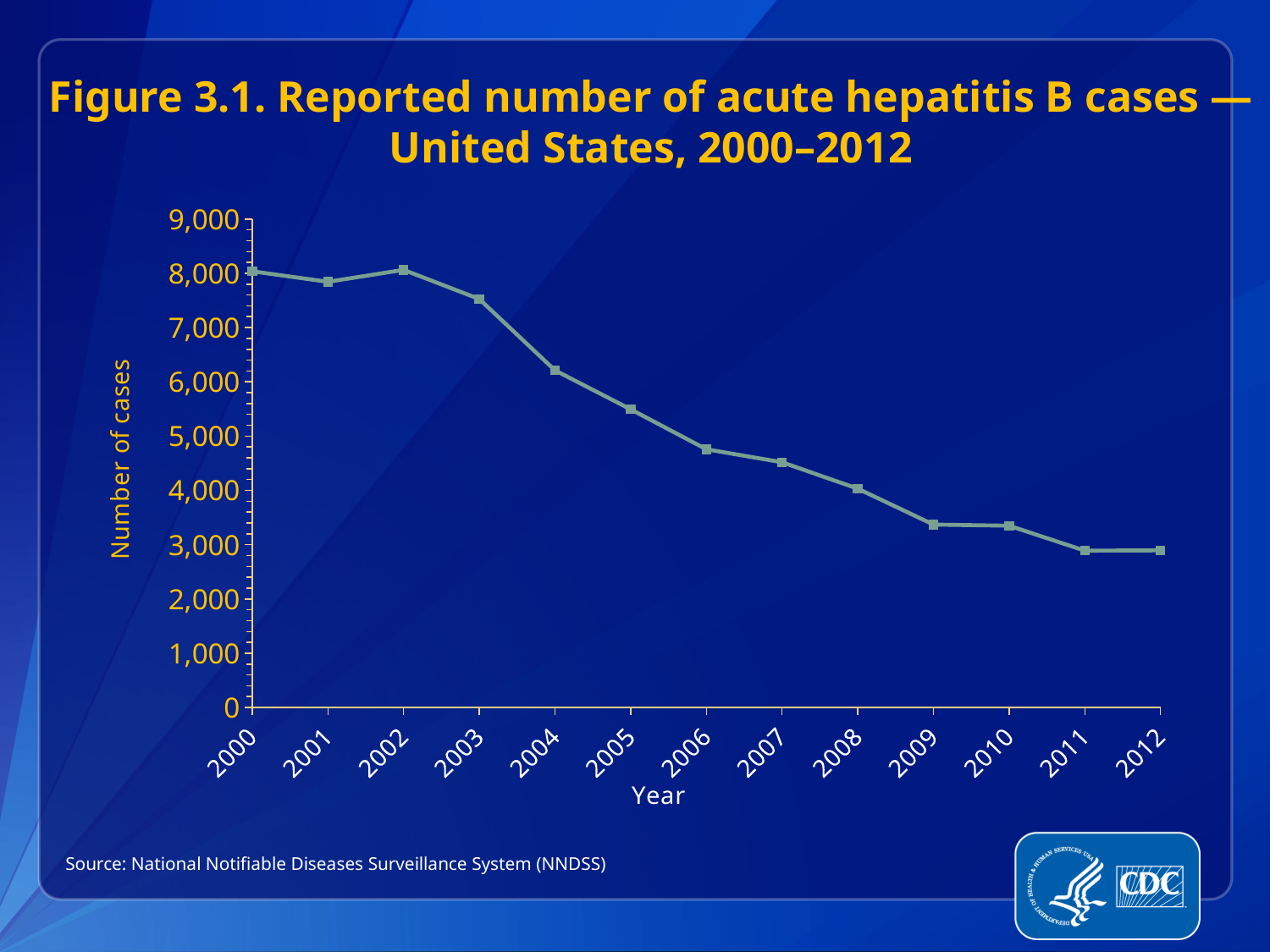
Is the number of cases for 2009 greater or less than 3,000? greater Which year had more reported cases, 2000 or 2012? 2000 What is the label on the vertical axis of the chart? Number of cases Overall, do the reported acute hepatitis B cases rise or fall from 2000 to 2012? fall Which year had more reported cases, 2003 or 2004? 2003 How many years (data points) are plotted on the chart? 13 Is the number of cases for 2004 greater or less than 6,000? greater What data source is cited below the chart? National Notifiable Diseases Surveillance System (NNDSS) Is the number of cases for 2003 greater or less than 7,000? greater What kind of chart is shown on the slide? line chart